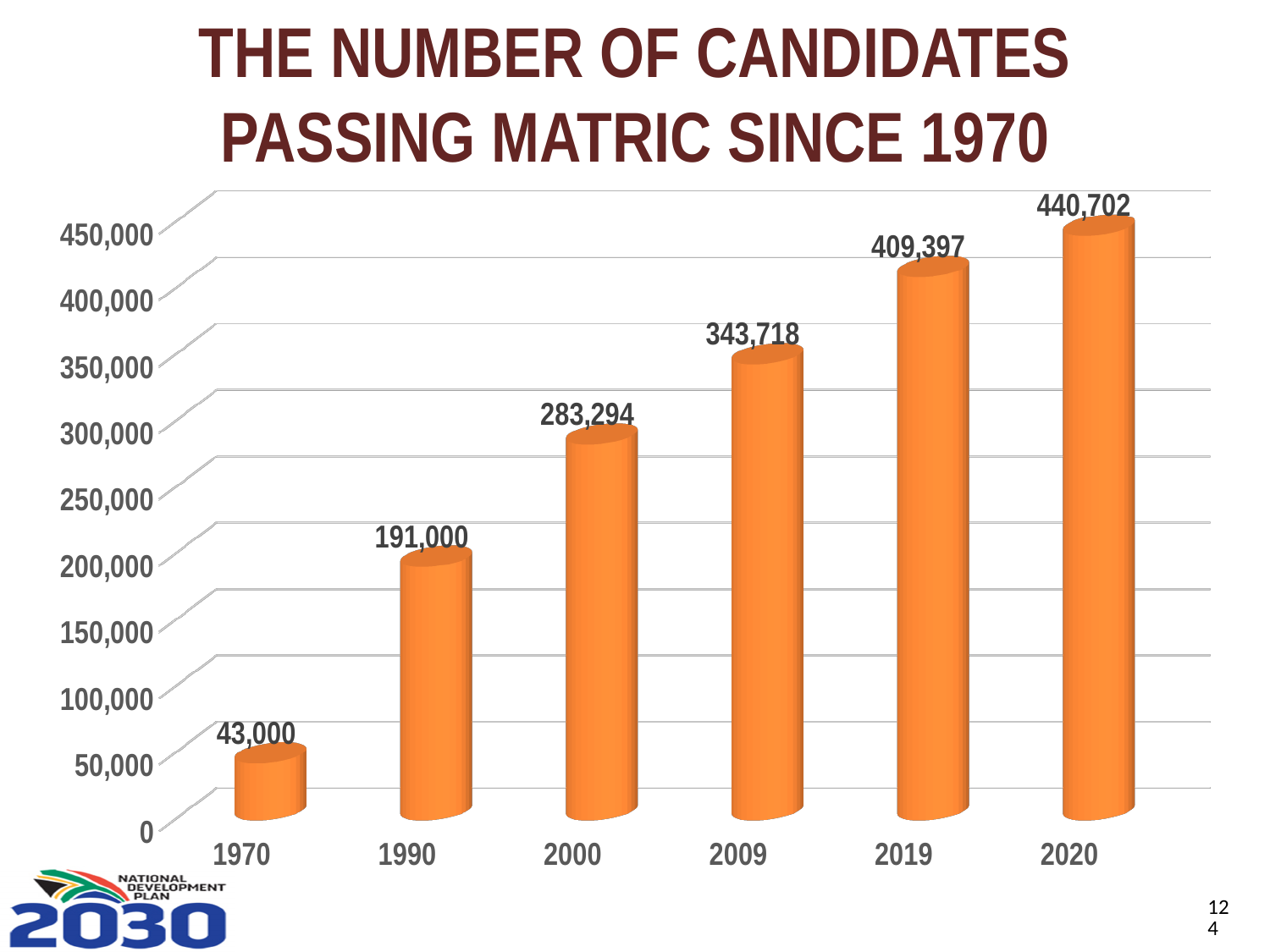
Which year has the highest number of candidates passing matric? 2020 How many candidates passed matric in 1970 according to the chart? 43,000 What kind of chart is shown on the slide? bar chart Is the value for 1990 greater or less than 200,000? less Which year has the lowest number of candidates passing matric? 1970 What is the difference between the values for 2020 and 2019? 31,305 Do the values rise or fall from 1970 to 2020? rise What is the value shown for 2019? 409,397 How many years are shown on the x axis of the chart? 6 What is the difference between the values for 2000 and 1990? 92,294 What is the value shown for 2009? 343,718 Which is larger, the value for 2000 or the value for 2009? 2009